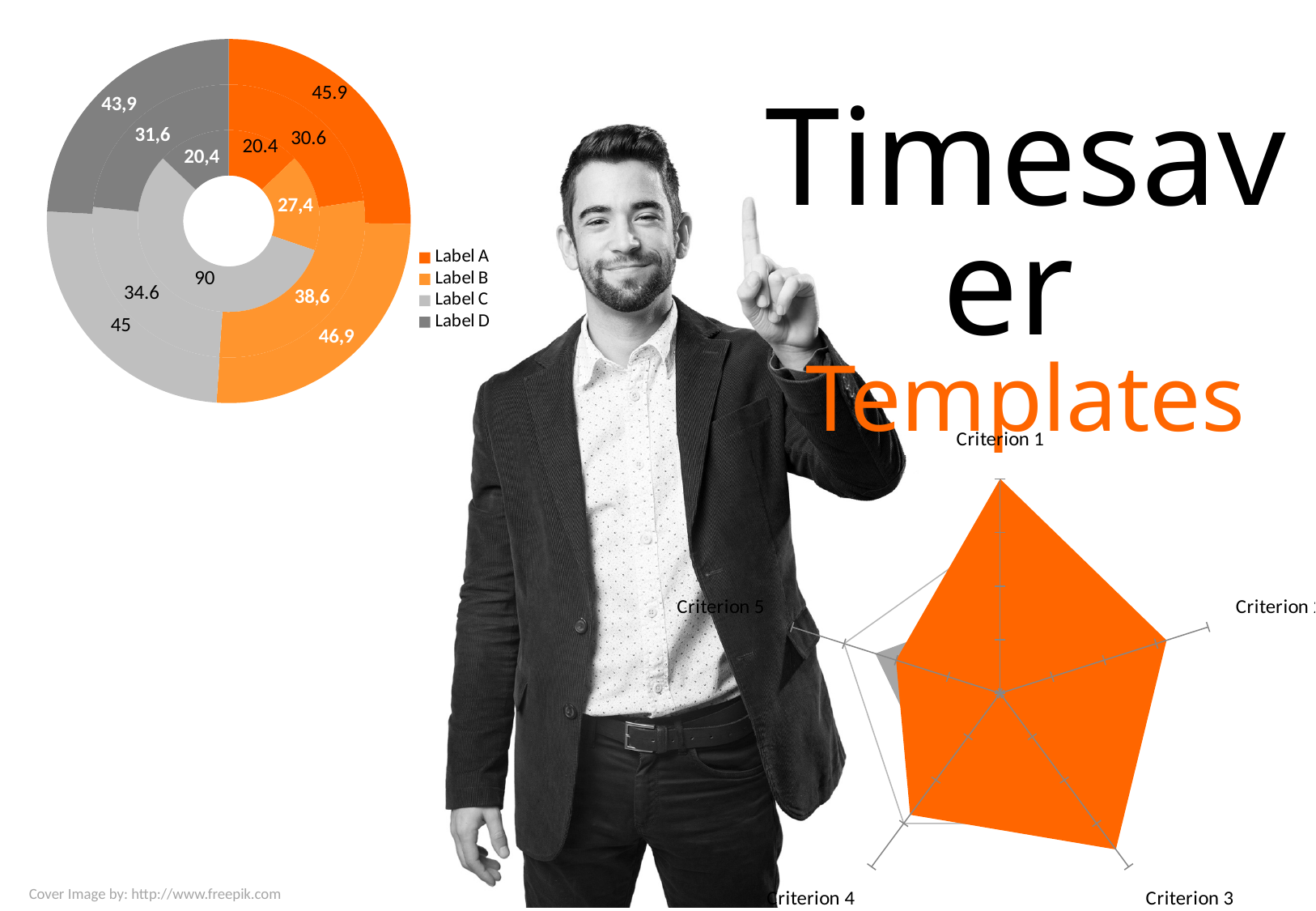
In the doughnut chart on the left, which label has the lowest value in the outer ring? Label D In the doughnut chart on the left, what is the inner-ring value for Label C? 90 How many series does the legend of the doughnut chart on the left list? 4 In the doughnut chart on the left, what is the outer-ring value for Label B? 46,9 In the doughnut chart on the left, what is the outer-ring value for Label D? 43,9 What kind of chart is the chart on the right of the slide? radar chart What kind of chart is the chart on the left of the slide? doughnut chart In the doughnut chart on the left, what is the difference between the outer-ring values of Label A and Label D? 2 In the radar chart on the right, which criterion has the lowest value? Criterion 5 In the doughnut chart on the left, what is the middle-ring value for Label B? 38,6 In the doughnut chart on the left, which is larger in the middle ring: Label B or Label C? Label B In the radar chart on the right, which criterion has the highest value? Criterion 1